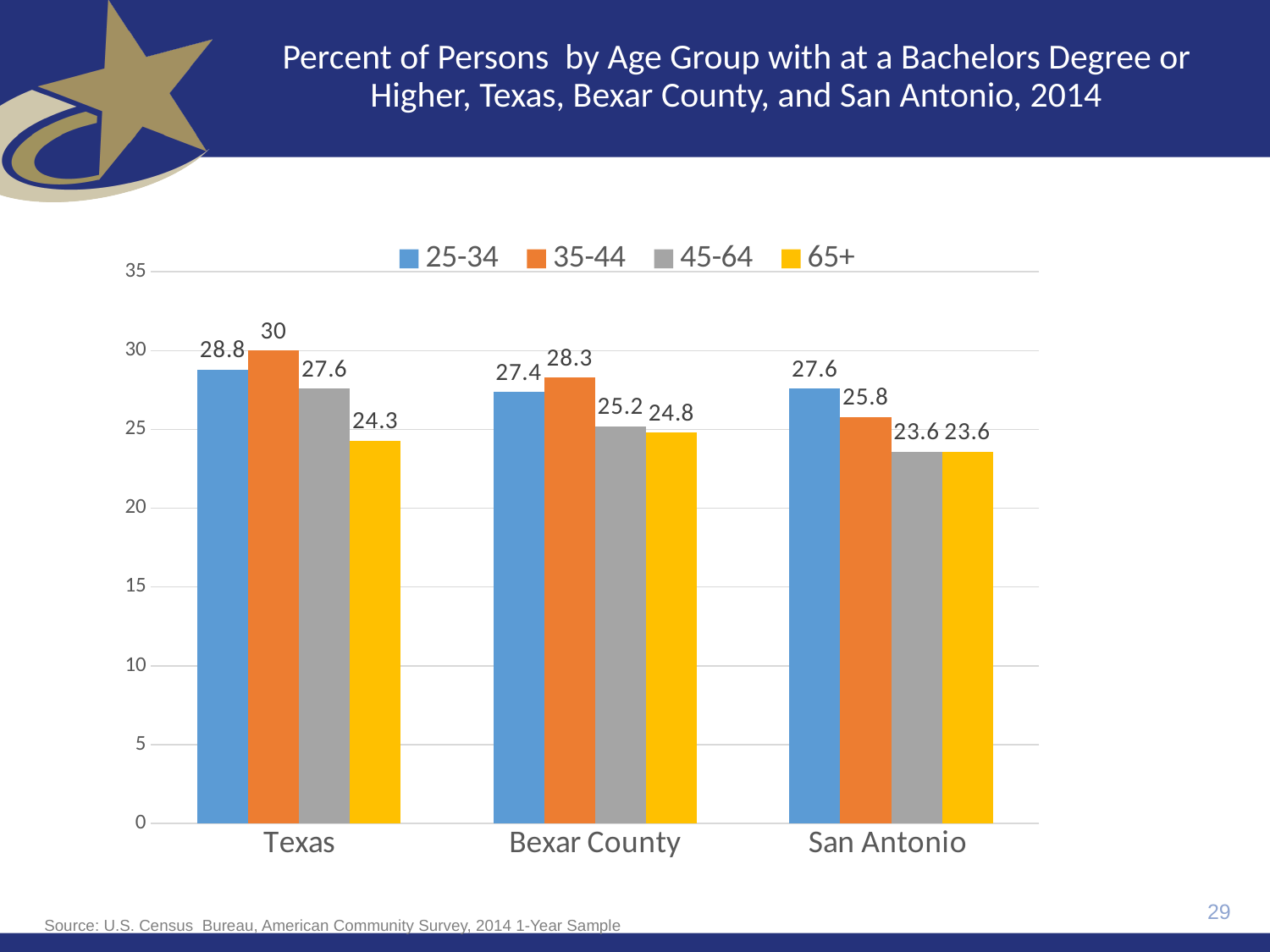
What is the difference between the 35-44 and 65+ values in Texas? 5.7 What is the value for the 35-44 age group in Texas? 30 Which age group has the highest value in Texas? 35-44 What is the difference between the 25-34 and 35-44 values in San Antonio? 1.8 Which age group has the lowest value in Bexar County? 65+ How many series does the legend list? 4 What is the value for the 25-34 age group in San Antonio? 27.6 What kind of chart is shown on the slide? Bar chart How many geographic categories are shown on the x axis? 3 Which is larger, the 45-64 value in Texas or the 45-64 value in Bexar County? Texas What colour represents the 65+ age group in the chart? Yellow What is the value for the 65+ age group in Bexar County? 24.8